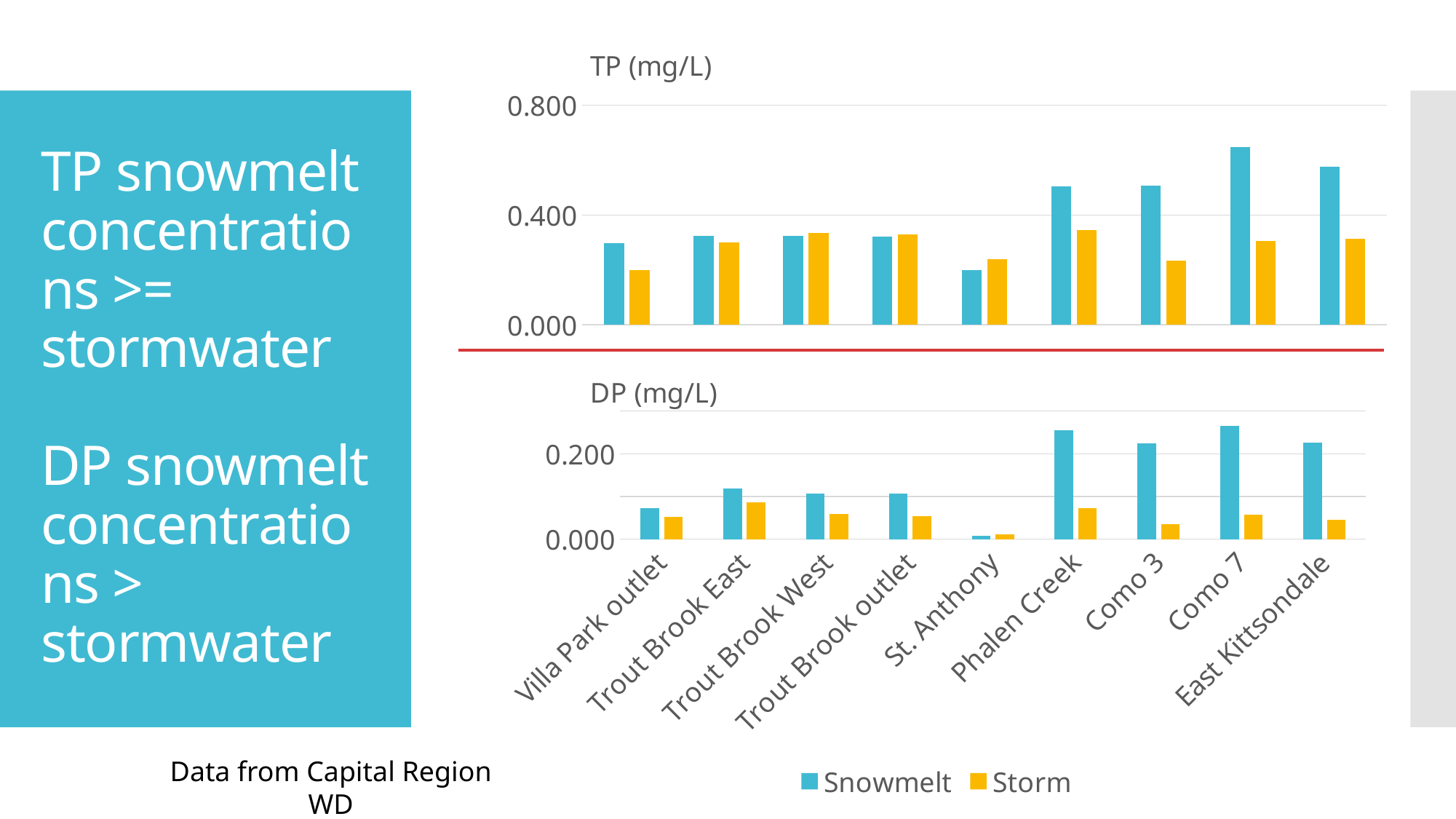
In the TP (mg/L) chart, which site has the highest Snowmelt value? Como 7 In the TP (mg/L) chart, is the Snowmelt value for Como 7 greater or less than 0.400? greater In the DP (mg/L) chart, which site has the lowest Snowmelt value? St. Anthony In the DP (mg/L) chart, which is larger for Phalen Creek, the Snowmelt value or the Storm value? Snowmelt In the TP (mg/L) chart, is the Storm value for Villa Park outlet greater or less than 0.400? less How many series does the legend list for the charts? 2 In the TP (mg/L) chart, which site has the lowest Snowmelt value? St. Anthony What kind of chart is the TP (mg/L) chart? bar chart In the DP (mg/L) chart, is the Snowmelt value for Phalen Creek greater or less than 0.200? greater How many sites are shown along the x axis of the DP (mg/L) chart? 9 In the TP (mg/L) chart, which is larger for Como 3, the Snowmelt value or the Storm value? Snowmelt What are the two series named in the legend? Snowmelt and Storm